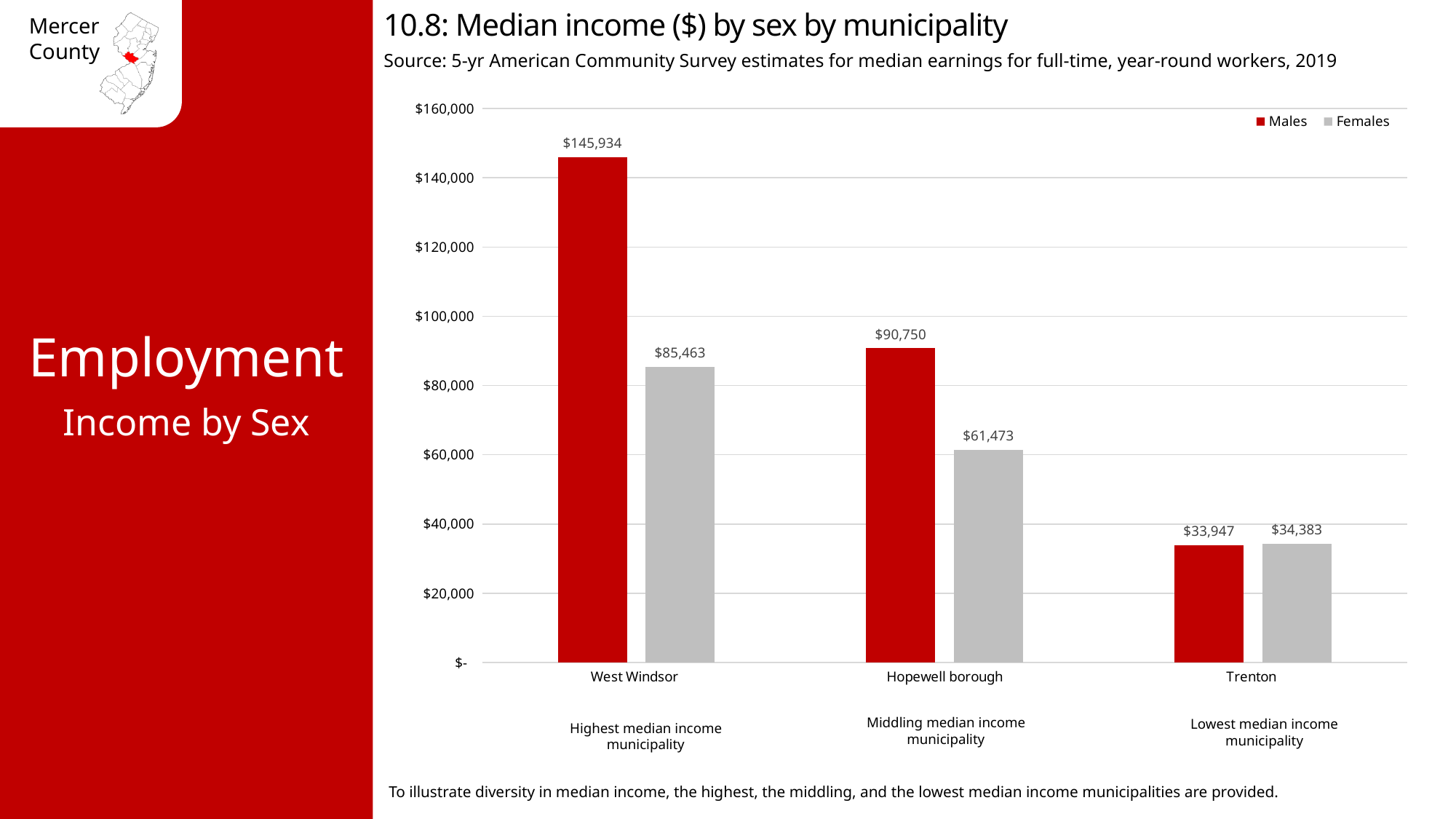
Which colour represents Males in the chart? Red What is the median income for females in Trenton? $34,383 What is the difference between male and female median income in Hopewell borough? $29,277 What kind of chart is shown on the slide? Bar chart How many series does the legend list? 2 Which municipality has the highest median income for males? West Windsor In Trenton, is the median income higher for males or females? Females What is the median income for females in Hopewell borough? $61,473 What is the difference between male and female median income in West Windsor? $60,471 What is the median income for males in West Windsor? $145,934 How many municipalities are shown on the x axis? 3 Which municipality has the lowest median income for females? Trenton